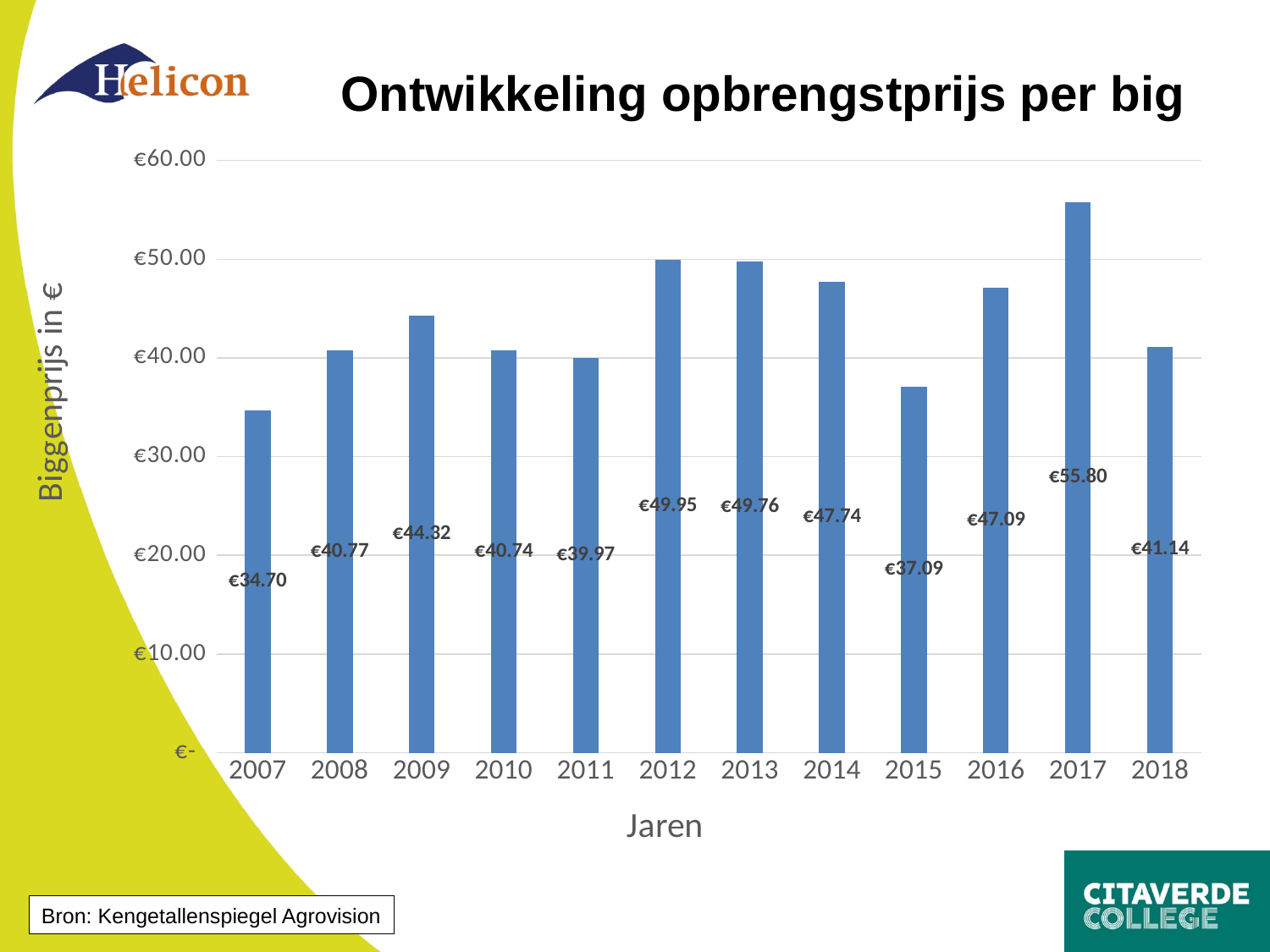
What kind of chart is this? bar chart Is the value for 2017 greater or less than €50.00? greater What is the difference between the values for 2012 and 2011? €9.98 What is the difference between the values for 2017 and 2007? €21.10 Which year has the highest value? 2017 Which year has the lowest value? 2007 What is the value for 2015? €37.09 What is the title of the chart? Ontwikkeling opbrengstprijs per big How many years are shown on the x axis? 12 Which is larger, the value for 2009 or the value for 2016? 2016 What is the value for 2017? €55.80 What is the value for 2007? €34.70